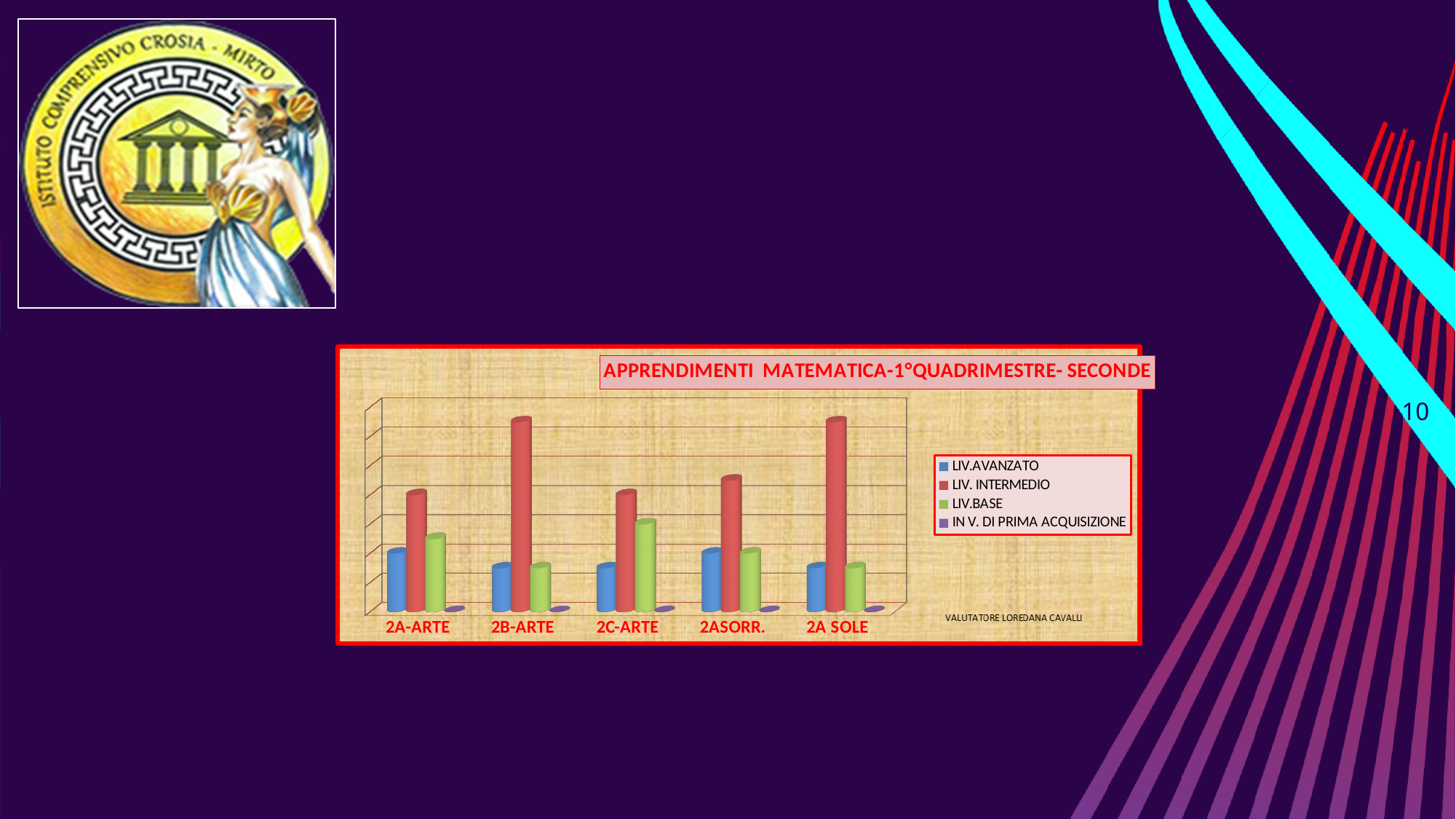
Which has the larger LIV. INTERMEDIO bar: 2A SOLE or 2C-ARTE? 2A SOLE Which has the larger LIV. INTERMEDIO bar: 2B-ARTE or 2ASORR.? 2B-ARTE In 2A-ARTE, which is larger: LIV. INTERMEDIO or LIV.AVANZATO? LIV. INTERMEDIO Which series is shown in red in the chart? LIV. INTERMEDIO What kind of chart is shown on the slide? bar chart How many categories (classes) are shown on the x axis of the chart? 5 Which category has the highest LIV.BASE bar? 2C-ARTE How many series does the chart legend list? 4 What is the title of the chart? APPRENDIMENTI MATEMATICA-1°QUADRIMESTRE- SECONDE